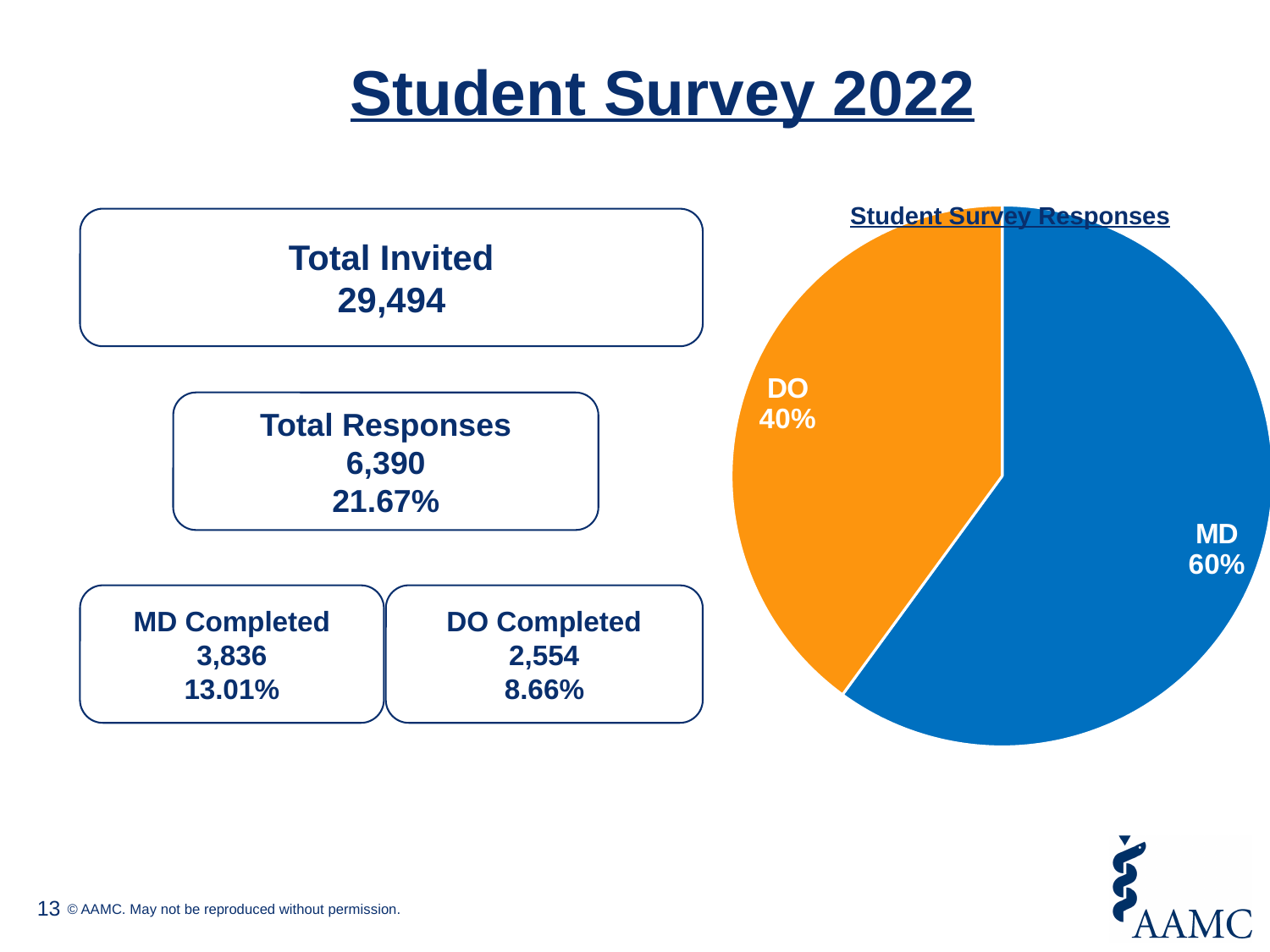
What share of the pie does the DO slice represent? 40% How many slices does the pie chart have? 2 Which slice of the pie chart is the largest? MD What is the difference in percentage points between the MD and DO slices? 20% What is the title of the pie chart? Student Survey Responses What share of the pie does the MD slice represent? 60% What kind of chart is shown on the slide? pie chart Is the share for the MD slice greater or less than 50%? greater Which slice of the pie chart is the smallest? DO What colour is the DO slice in the pie chart? orange Which slice is larger, MD or DO? MD